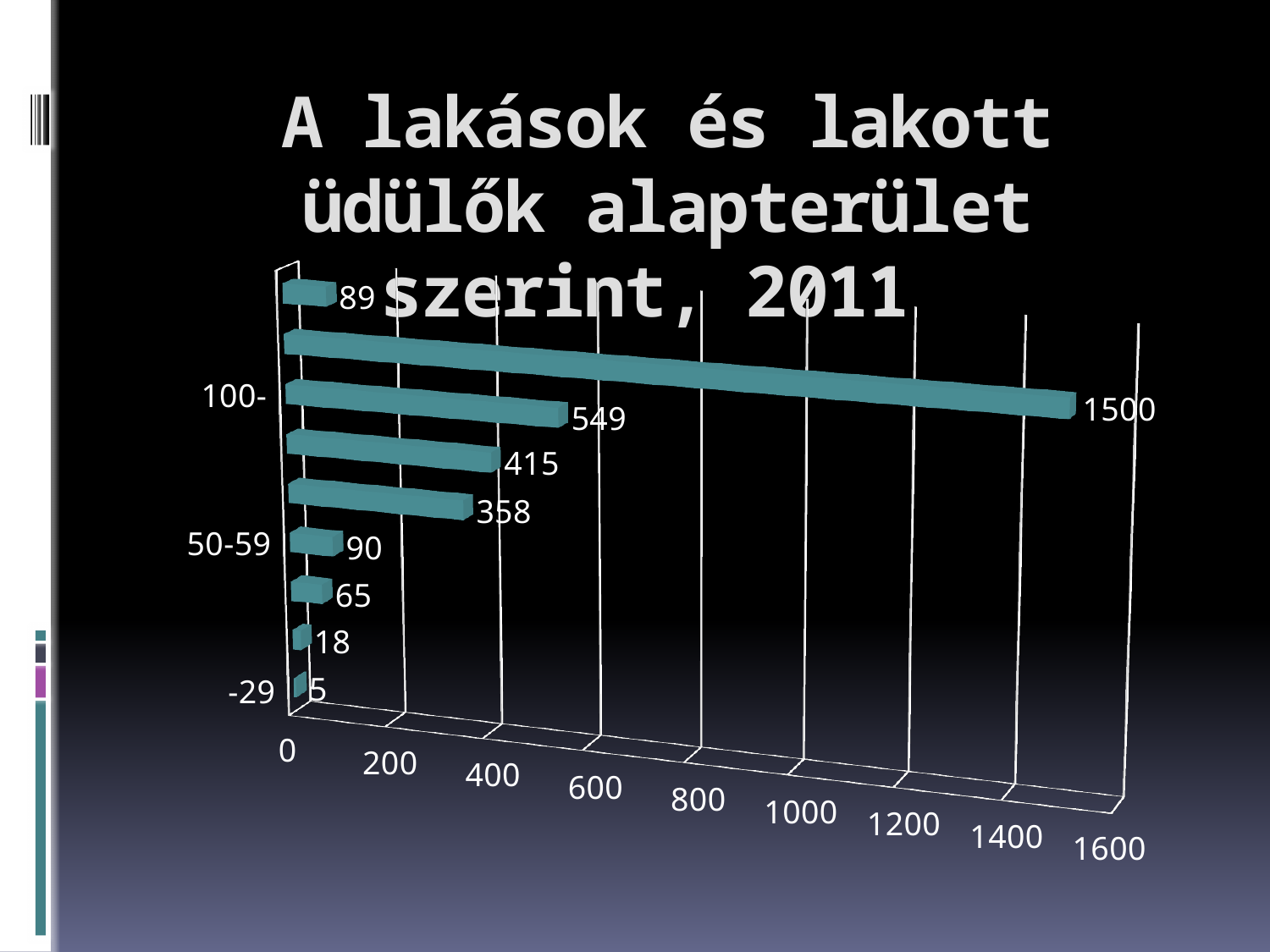
What is the smallest value shown on the chart? 5 What kind of chart is shown on the slide? Bar chart What is the largest value shown on the chart? 1500 What is the difference between the values for "100-" and "50-59"? 459 Which is larger, the value for "50-59" or the value for "-29"? 50-59 What is the title of the chart? A lakások és lakott üdülők alapterület szerint, 2011 Which labelled category has the lowest value? -29 How many bars are plotted on the chart? 9 What is the value for the category "100-"? 549 What is the value for the category "50-59"? 90 What is the value for the category "-29"? 5 What is the highest tick value shown on the value axis? 1600